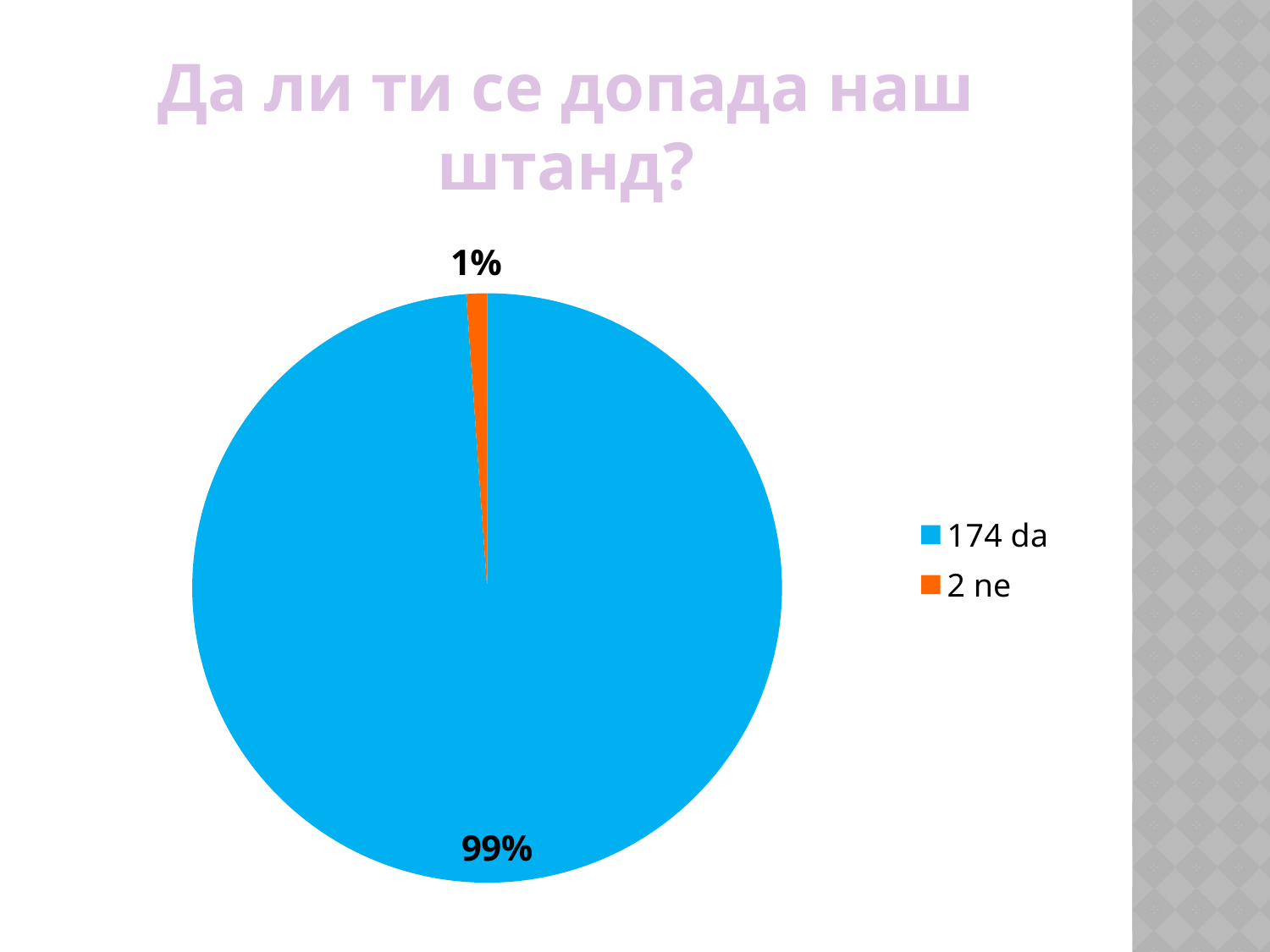
Which slice is the largest in the pie chart? 174 da How many entries does the legend list? 2 What percentage share does the "174 da" slice have? 99% Which slice is the smallest in the pie chart? 2 ne What percentage share does the "2 ne" slice have? 1% What is the difference in percentage points between the "174 da" slice and the "2 ne" slice? 98 What kind of chart is shown on the slide? pie chart Which is larger, the "174 da" slice or the "2 ne" slice? 174 da What colour is the "2 ne" slice? orange What is the title of the slide above the chart? Да ли ти се допада наш штанд? How many slices does the pie chart have? 2